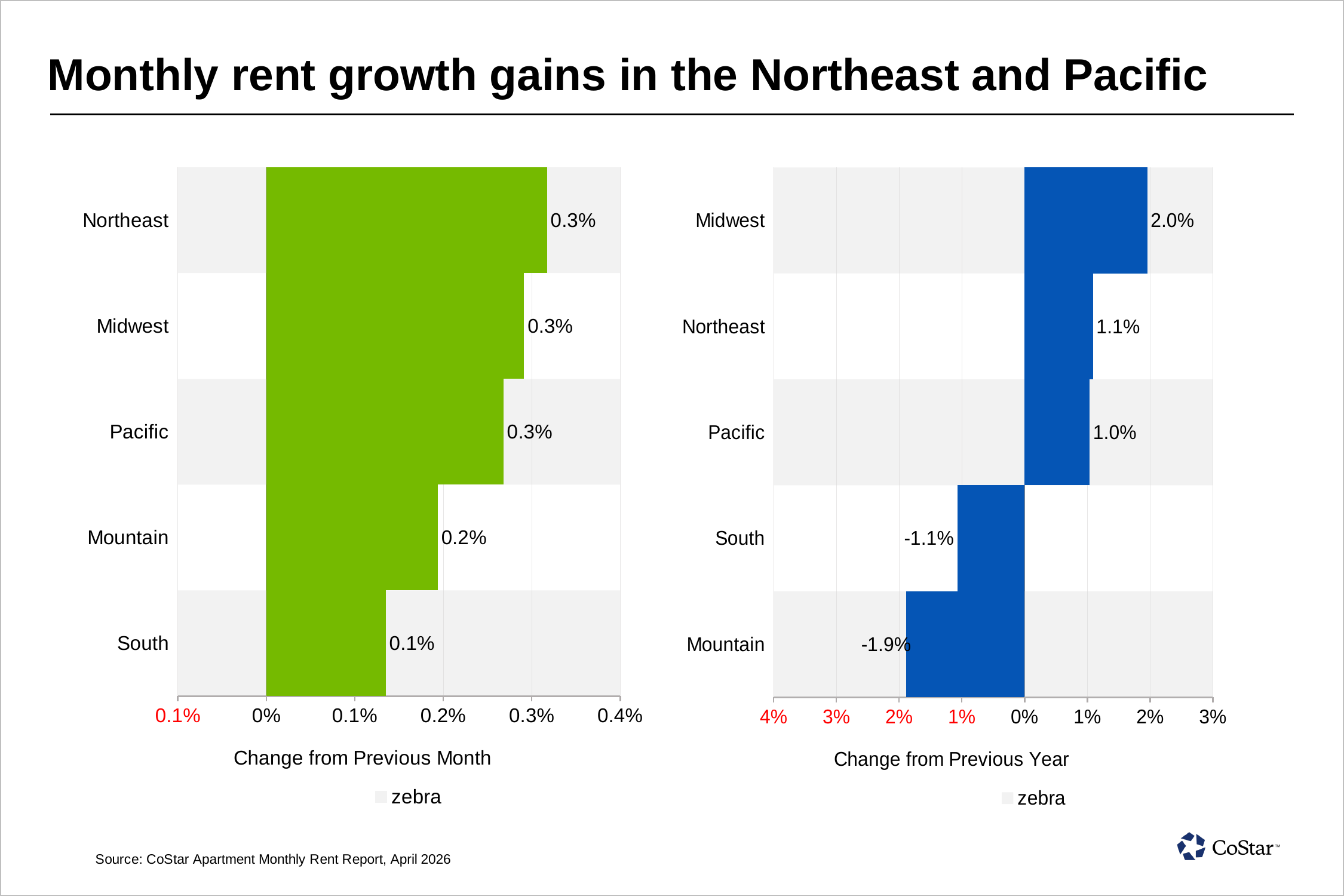
In the 'Change from Previous Month' chart, what is the value for Mountain? 0.2% In the 'Change from Previous Month' chart, what is the value for South? 0.1% In the 'Change from Previous Month' chart, which region has the lowest value? South In the 'Change from Previous Year' chart, is the value for Northeast or Pacific larger? Northeast How many regions are shown in the 'Change from Previous Month' chart? 5 In the 'Change from Previous Year' chart, which region has the highest value? Midwest In the 'Change from Previous Year' chart, what is the value for South? -1.1% What kind of chart is the 'Change from Previous Year' chart? Bar chart In the 'Change from Previous Year' chart, which region has the lowest value? Mountain In the 'Change from Previous Year' chart, what is the difference between the Midwest and Northeast values? 0.9 percentage points In the 'Change from Previous Year' chart, what is the value for Midwest? 2.0% In the 'Change from Previous Year' chart, what is the value for Mountain? -1.9%